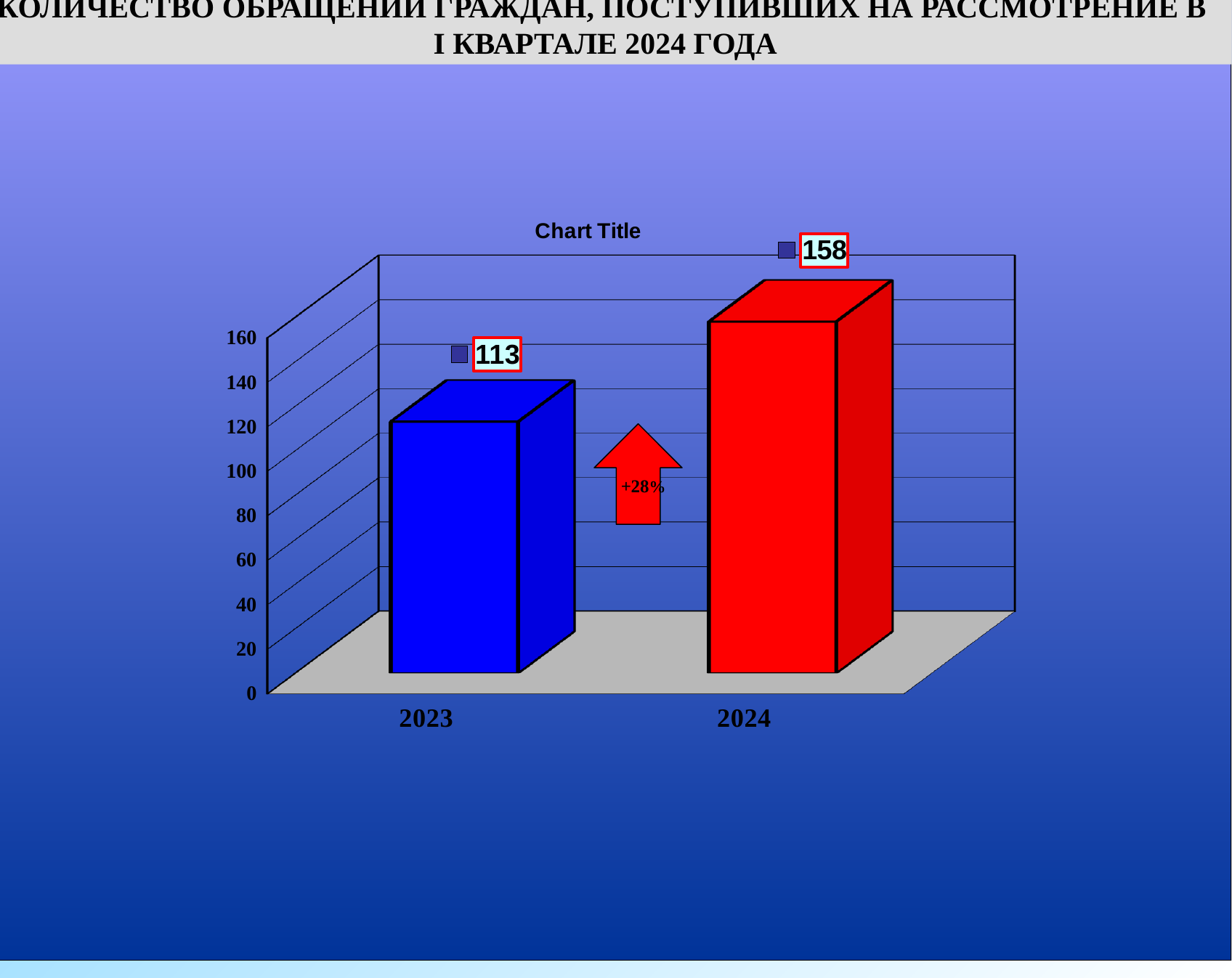
Which year has the lower value? 2023 What is the value for 2023? 113 What is the value for 2024? 158 Is the value for 2024 larger than the value for 2023? Yes How many categories are shown on the x axis? 2 What percentage change is written on the arrow between the two bars? +28% What kind of chart is shown on the slide? Bar chart Which year has the higher value? 2024 What is the difference between the values for 2024 and 2023? 45 Is the value for 2023 greater or less than 120? less Do the values rise or fall from 2023 to 2024? Rise Is the value for 2024 greater or less than 140? greater